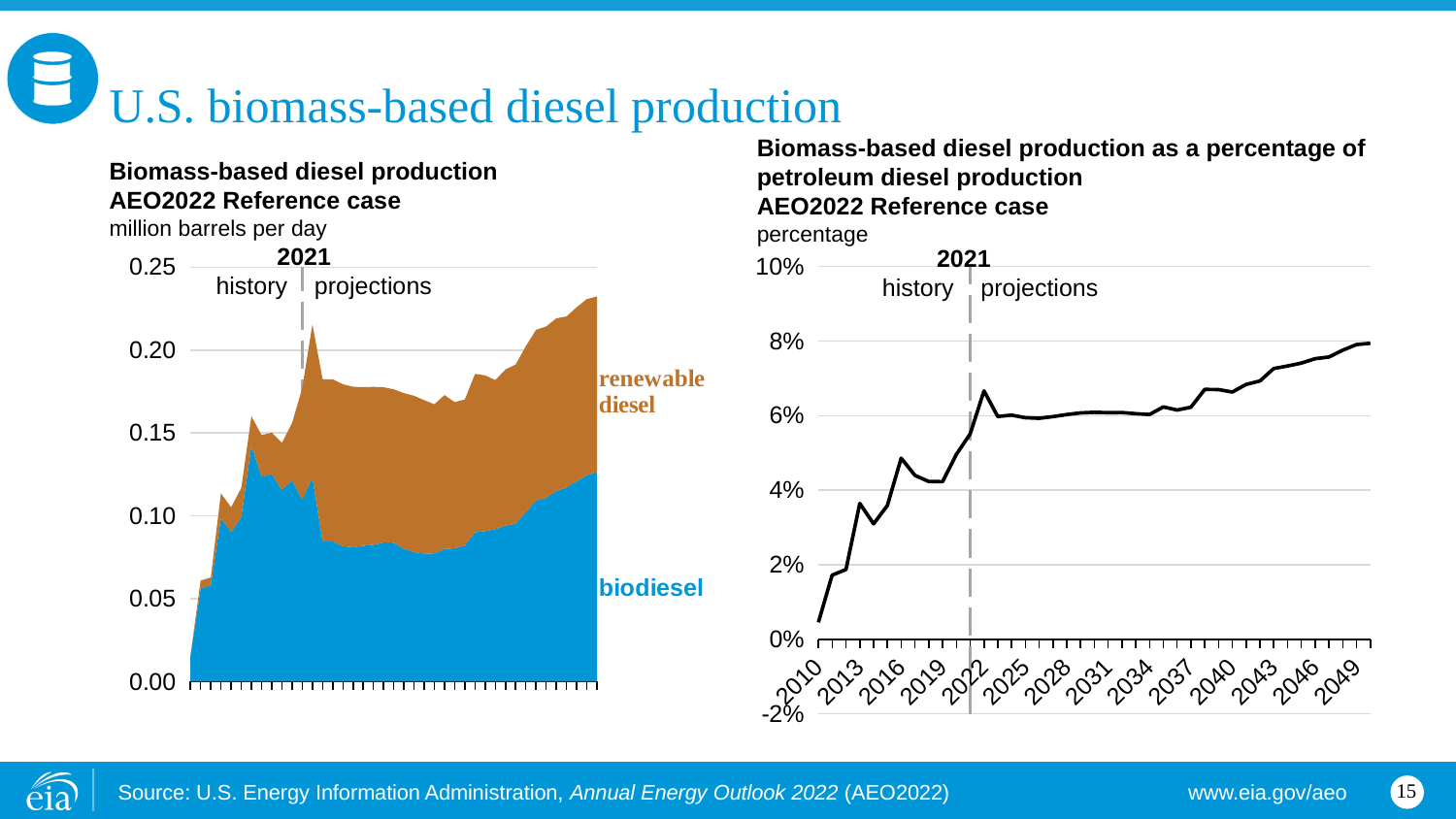
What kind of chart is the left chart, 'Biomass-based diesel production'? area chart In the right chart, 'Biomass-based diesel production as a percentage of petroleum diesel production', does the percentage generally rise or fall from 2010 to 2049? rise In the left chart, 'Biomass-based diesel production', what unit is shown on the y axis? million barrels per day In the left chart, 'Biomass-based diesel production', is the total biomass-based diesel production at the end of the projection period greater or less than 0.20? greater What kind of chart is the right chart, 'Biomass-based diesel production as a percentage of petroleum diesel production'? line chart In the left chart, 'Biomass-based diesel production', is the biodiesel value at the end of the projection period greater or less than 0.10? greater In the left chart, 'Biomass-based diesel production', which series is shown in blue? biodiesel In the left chart, 'Biomass-based diesel production', does total production generally rise or fall from the start of the history period to the end of the projections? rise In the right chart, 'Biomass-based diesel production as a percentage of petroleum diesel production', is the value for 2040 greater or less than 6%? greater In the left chart, 'Biomass-based diesel production', how many series are plotted? 2